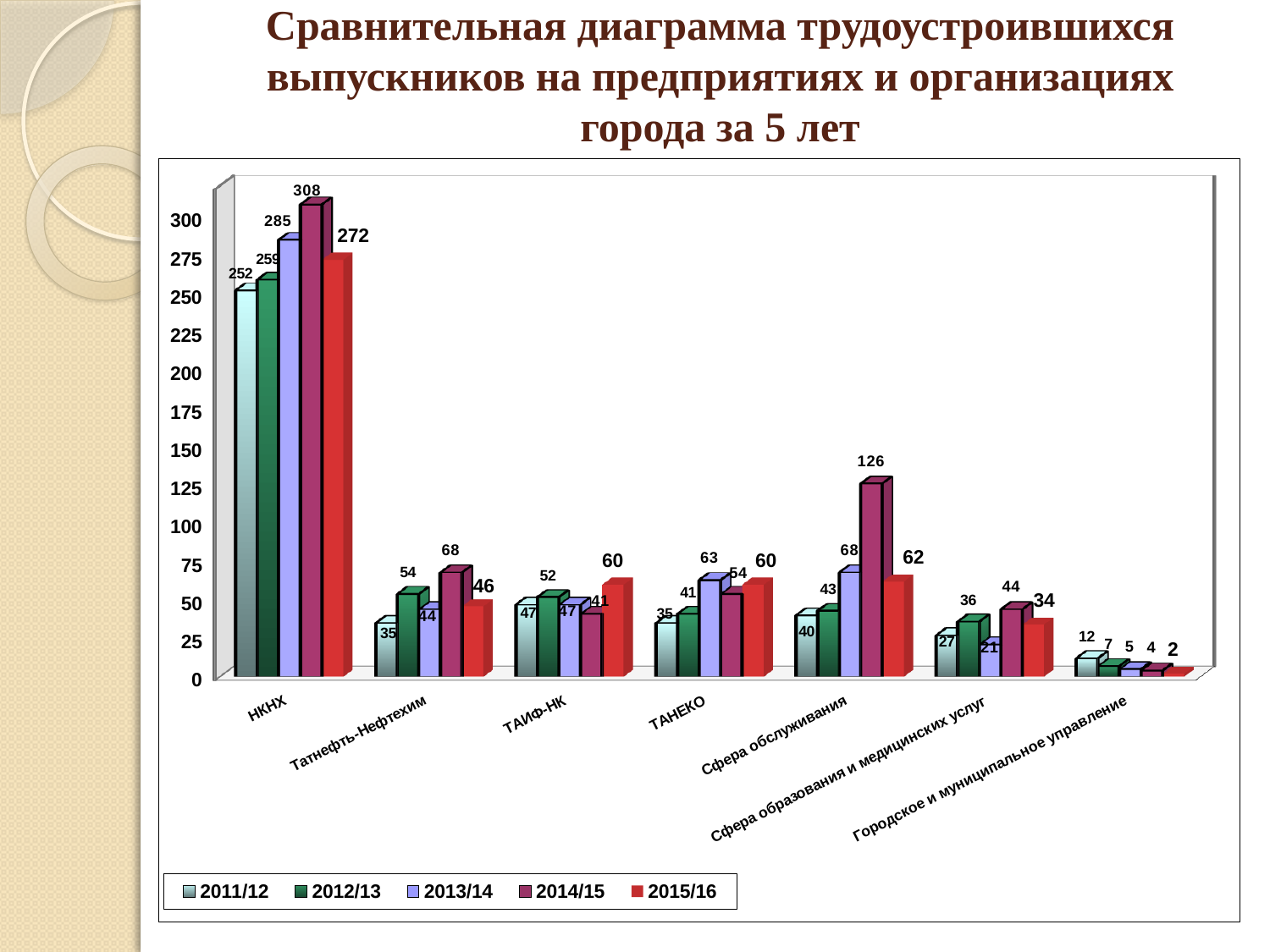
Do the values for Городское и муниципальное управление rise or fall from 2011/12 to 2015/16? fall Which series is shown in red in the legend? 2015/16 What is the difference between the 2014/15 and 2011/12 values for НКНХ? 56 How many categories are shown on the x axis? 7 How many series does the legend list? 5 What is the value for ТАНЕКО in 2013/14? 63 Which is larger for Татнефть-Нефтехим: the 2012/13 value or the 2015/16 value? 2012/13 What is the value for Сфера обслуживания in 2014/15? 126 Which category has the lowest value in 2011/12? Городское и муниципальное управление Which category has the highest value in 2015/16? НКНХ What is the value for НКНХ in 2014/15? 308 What type of chart is shown on the slide? bar chart